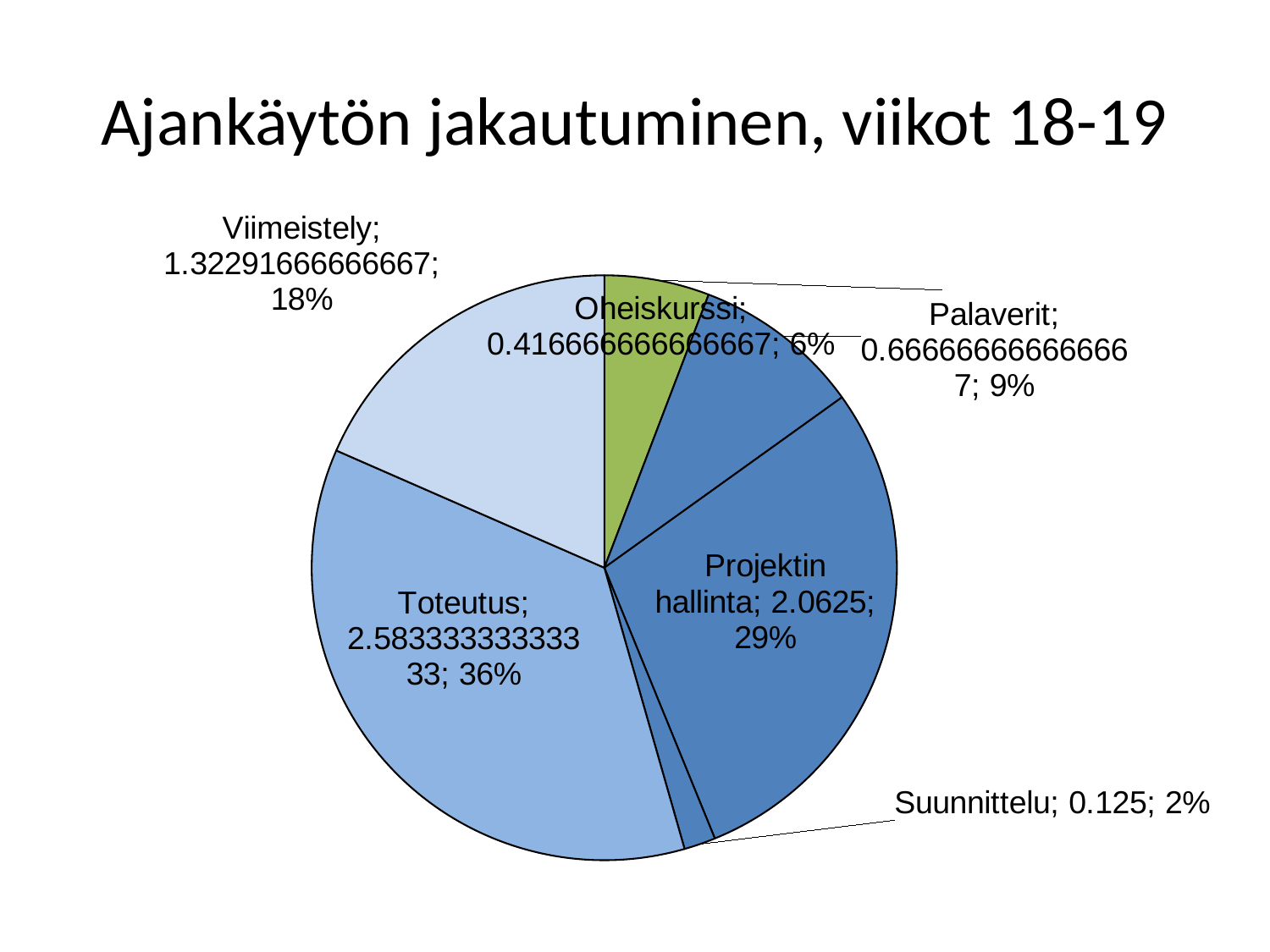
What percentage share of the pie does Toteutus have? 36% What is the title of the chart? Ajankäytön jakautuminen, viikot 18-19 Which category has the smallest slice of the pie? Suunnittelu What percentage share does Viimeistely have? 18% What is the value shown for Projektin hallinta? 2.0625 Which has a larger share, Palaverit or Oheiskurssi? Palaverit Which category has the largest slice of the pie? Toteutus How many percentage points larger is the share of Toteutus than the share of Projektin hallinta? 7 How many categories are shown in the pie chart? 6 What percentage share of the pie does Projektin hallinta have? 29% What type of chart is shown on the slide? pie chart What is the value shown for Suunnittelu? 0.125